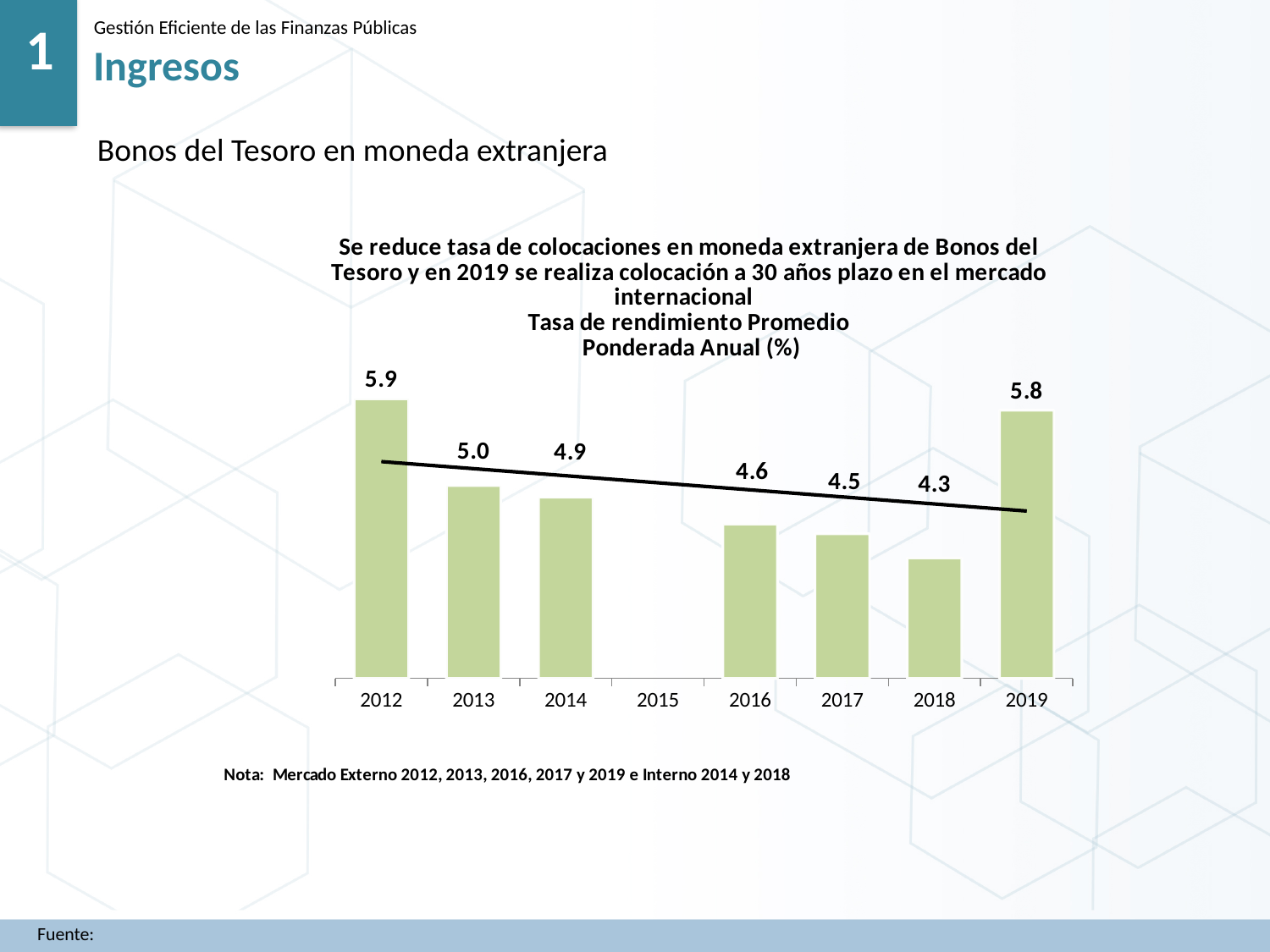
What kind of chart is shown? Bar chart Which year on the x axis has no bar? 2015 What is the value for 2019? 5.8 How many bars are plotted in the chart? 7 Which year has the highest value? 2012 What is the value for 2018? 4.3 What is the value for 2016? 4.6 Which year with a bar has the lowest value? 2018 What is the difference between the values for 2012 and 2018? 1.6 Which is larger, the value for 2013 or the value for 2017? 2013 What is the value for 2012? 5.9 Do the values fall or rise from 2012 to 2018? Fall